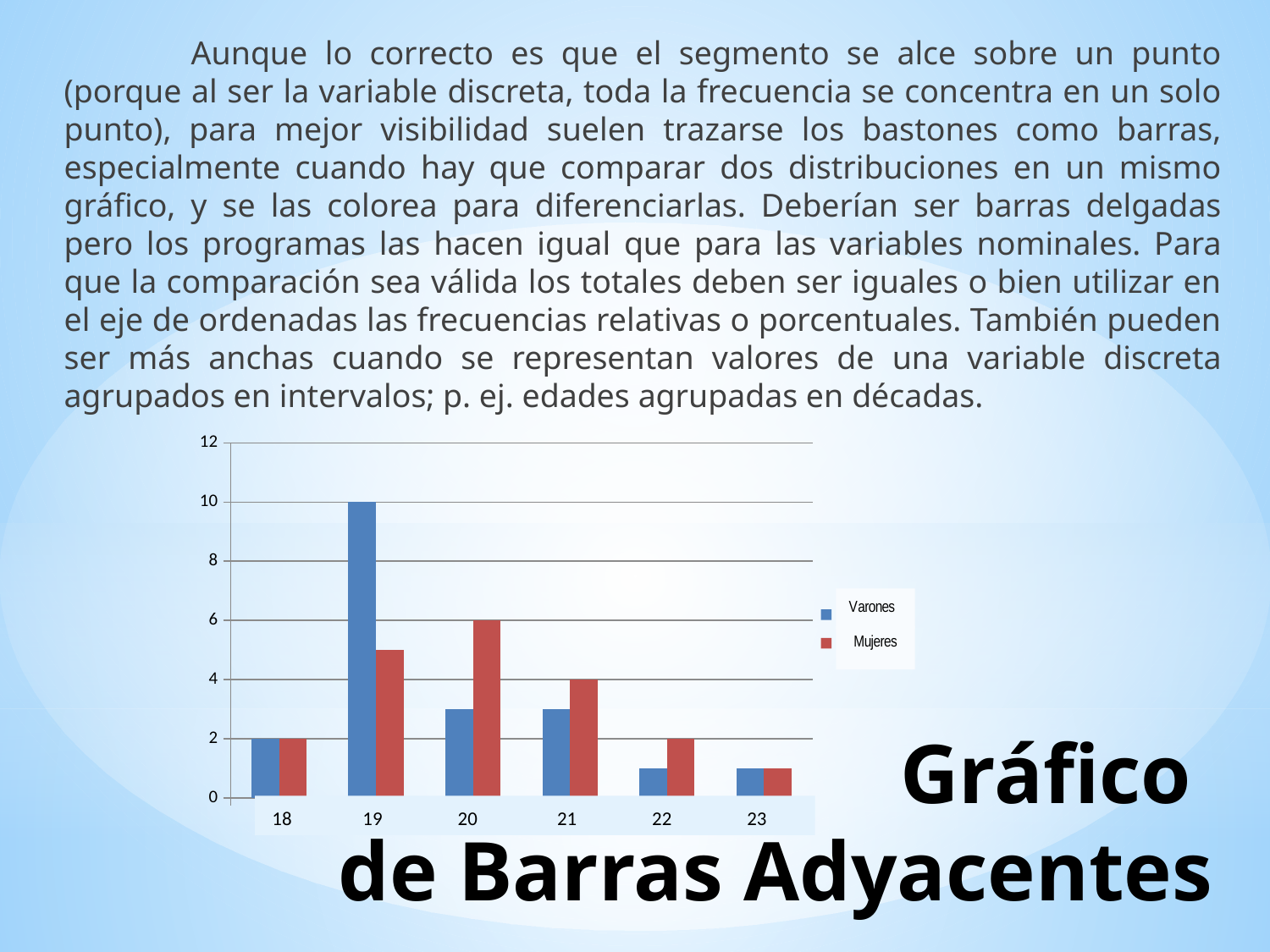
What is the difference between the Varones value at age 19 and the Mujeres value at age 20? 4 What is the value for Varones at age 18? 2 At age 20, which series has the larger value, Varones or Mujeres? Mujeres What kind of chart is shown on the slide? bar chart What is the value for Mujeres at age 20? 6 Which age has the highest value for Mujeres? 20 What is the value for Varones at age 19? 10 Is the value for Mujeres at age 19 greater or less than 4? greater Which age has the highest value for Varones? 19 How many series does the chart legend list? 2 How many age categories are shown on the x axis of the chart? 6 What is the value for Mujeres at age 21? 4